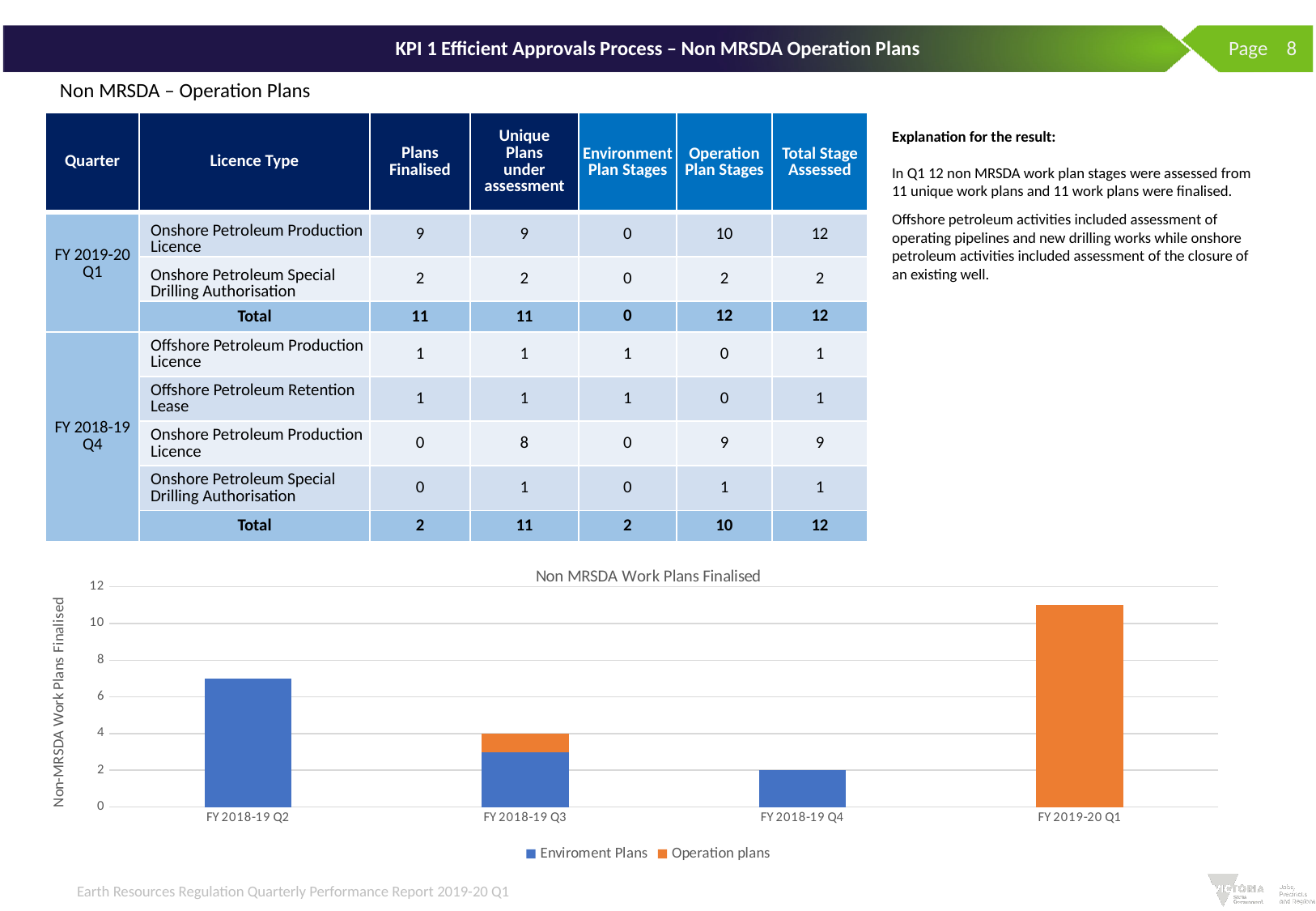
What are the two series named in the legend of the 'Non MRSDA Work Plans Finalised' chart? Enviroment Plans and Operation plans In the 'Non MRSDA Work Plans Finalised' chart, which bar is taller: FY 2018-19 Q2 or FY 2018-19 Q3? FY 2018-19 Q2 In the 'Non MRSDA Work Plans Finalised' chart, which quarter has the tallest bar? FY 2019-20 Q1 What kind of chart is 'Non MRSDA Work Plans Finalised'? Bar chart In the 'Non MRSDA Work Plans Finalised' chart, what is the value of the bar for FY 2018-19 Q4? 2 In the 'Non MRSDA Work Plans Finalised' chart, is the value for FY 2018-19 Q2 greater or less than 8? less How many series does the legend of the 'Non MRSDA Work Plans Finalised' chart list? 2 In the 'Non MRSDA Work Plans Finalised' chart, what is the total height of the stacked bar for FY 2018-19 Q3? 4 In the 'Non MRSDA Work Plans Finalised' chart, does the value rise or fall from FY 2018-19 Q4 to FY 2019-20 Q1? rise How many quarters are shown on the x axis of the 'Non MRSDA Work Plans Finalised' chart? 4 In the 'Non MRSDA Work Plans Finalised' chart, which quarter has the shortest bar? FY 2018-19 Q4 In the 'Non MRSDA Work Plans Finalised' chart, is the value for FY 2019-20 Q1 greater or less than 10? greater